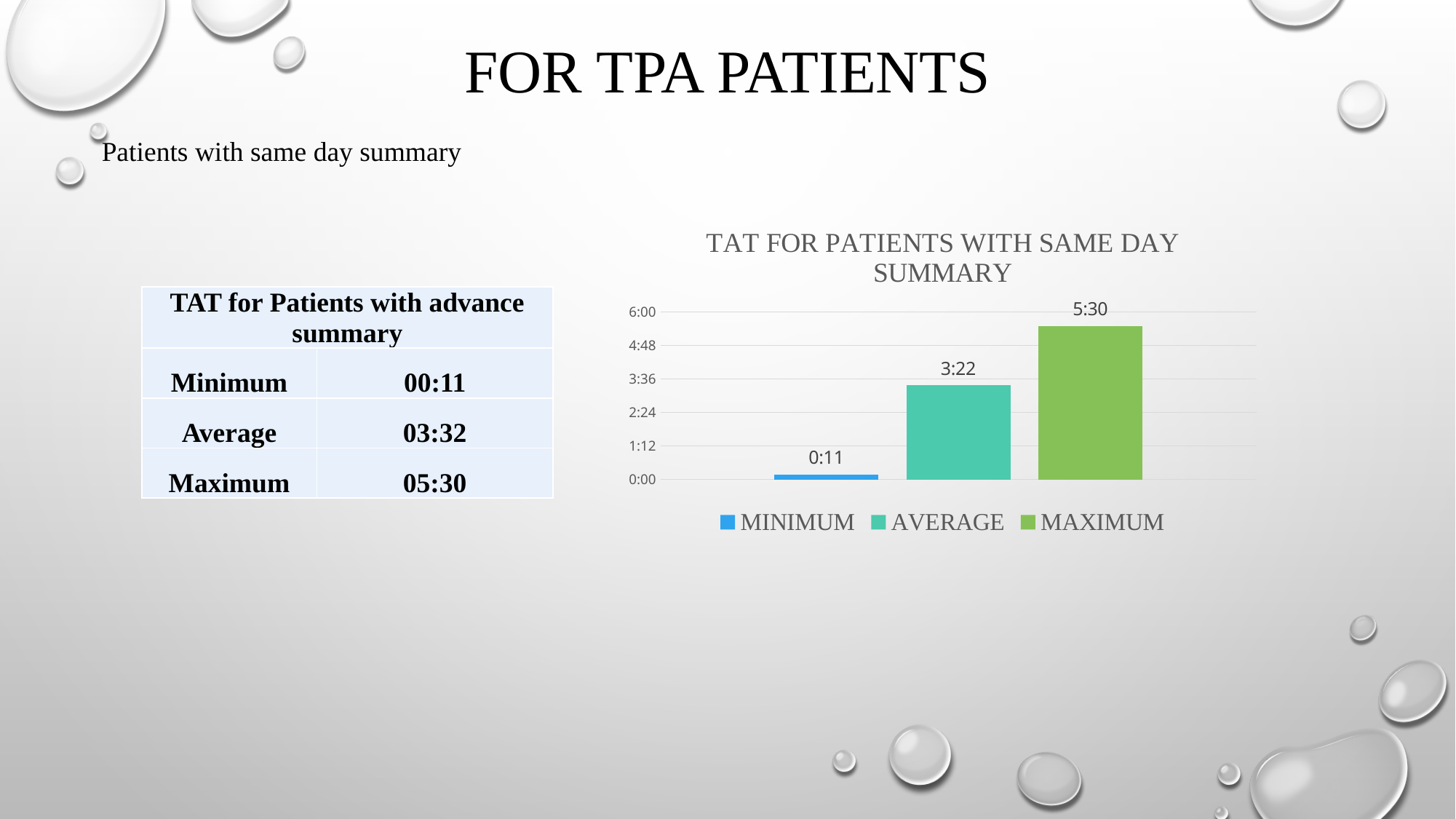
Which series has the lowest value in the chart? MINIMUM What is the difference between the AVERAGE and MINIMUM values in the chart? 3:11 What is the value of the MAXIMUM bar in the chart? 5:30 Which is larger in the chart, the AVERAGE value or the MINIMUM value? AVERAGE What is the value of the AVERAGE bar in the chart? 3:22 What is the title of the chart on the slide? TAT FOR PATIENTS WITH SAME DAY SUMMARY Is the value for MAXIMUM greater or less than 4:48? greater How many series does the chart legend list? 3 What is the value of the MINIMUM bar in the chart? 0:11 What is the difference between the MAXIMUM and AVERAGE values in the chart? 2:08 Which series has the highest value in the chart? MAXIMUM What kind of chart is shown on the slide? bar chart